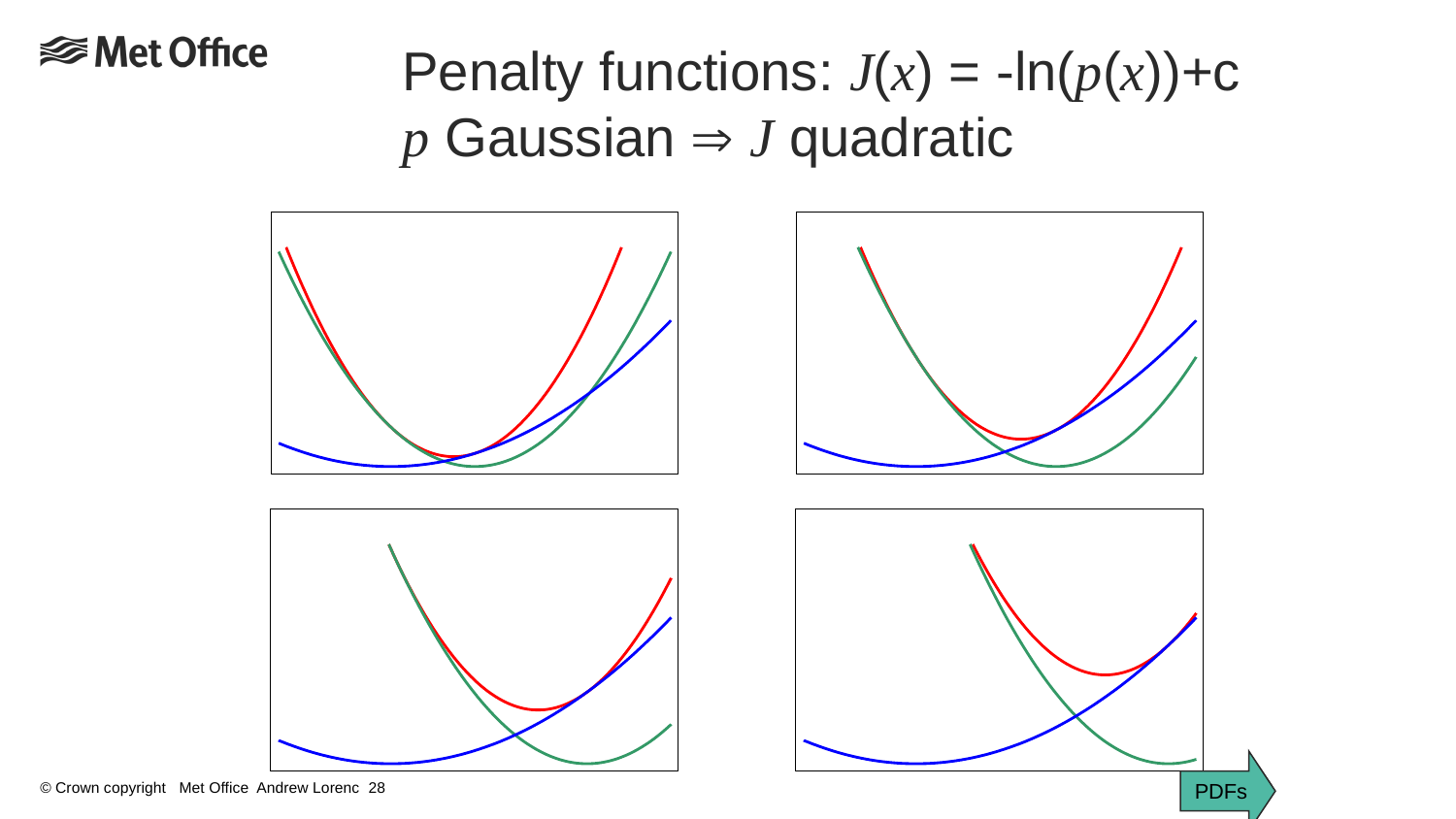
In the bottom-right chart panel, at the right-hand edge, which curve is higher, the red curve or the green curve? the red curve What kind of chart is shown in the bottom-right panel of the slide? line chart In the bottom-left chart panel, at the left-hand edge, which curve is higher, the green curve or the blue curve? the green curve Do the chart panels on the slide show a legend? No In the bottom-right chart panel, does the green curve rise or fall from left to right? fall What colours are the three curves in each chart panel? red, green and blue In the top-right chart panel, at the right-hand edge, which curve is highest? the red curve How many curves are drawn in the top-left chart panel? 3 How many chart panels are shown on the slide? 4 What kind of chart is shown in the top-left panel of the slide? line chart